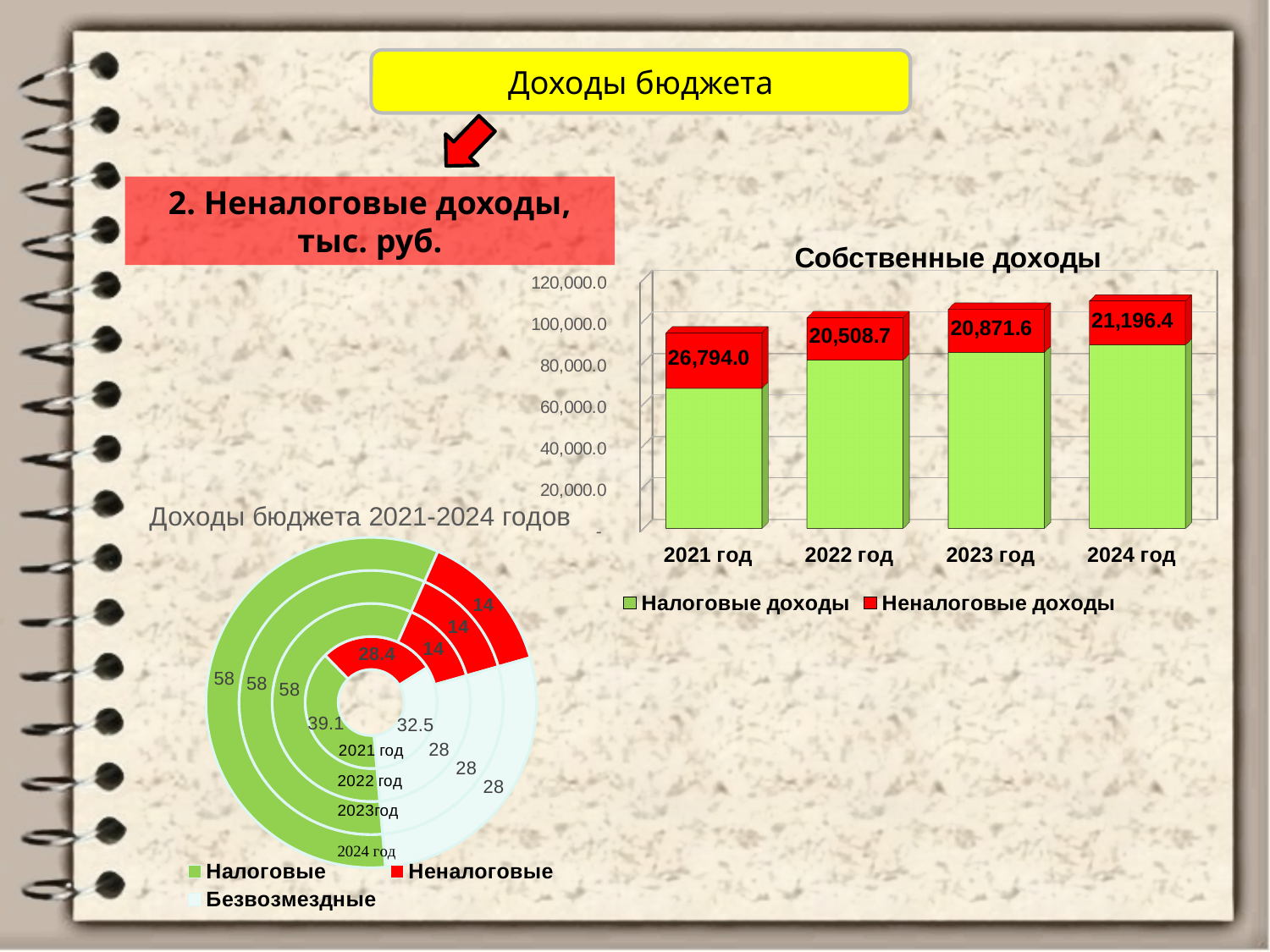
On the 'Собственные доходы' chart, what is the difference between Неналоговые доходы in 2024 год and 2022 год? 687.7 On the 'Собственные доходы' chart, what is the value of Неналоговые доходы for 2021 год? 26,794.0 On the 'Собственные доходы' chart, which year has the lowest value of Неналоговые доходы? 2022 год On the 'Собственные доходы' chart, what is the value of Неналоговые доходы for 2024 год? 21,196.4 On the 'Собственные доходы' chart, which year has the highest value of Неналоговые доходы? 2021 год How many entries does the legend of the 'Доходы бюджета 2021-2024 годов' chart list? 3 How many series does the legend of the 'Собственные доходы' chart list? 2 On the 'Доходы бюджета 2021-2024 годов' chart, what is the Неналоговые value for 2021 год? 28.4 What kind of chart is 'Собственные доходы'? Stacked bar chart On the 'Собственные доходы' chart, is Неналоговые доходы larger in 2023 год or 2024 год? 2024 год On the 'Доходы бюджета 2021-2024 годов' chart, what is the Налоговые value for 2023 год? 58 On the 'Собственные доходы' chart, is the Налоговые доходы value for 2021 год greater or less than 80,000.0? less